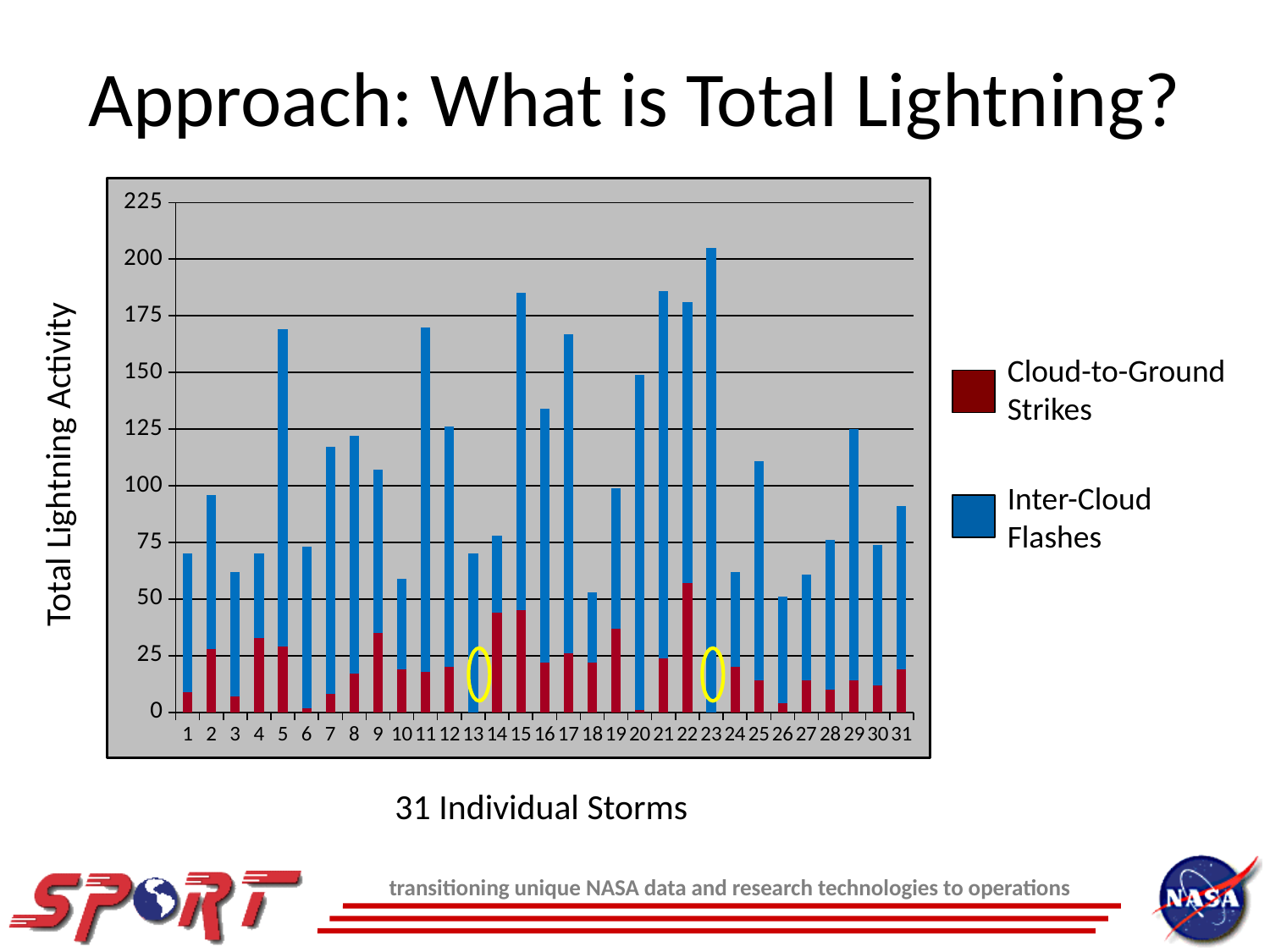
Which storm has the largest Cloud-to-Ground Strikes segment? 22 Which storm has a higher total lightning activity, storm 10 or storm 11? 11 What kind of chart is shown on the slide? Stacked bar chart How many series does the legend list? 2 Is the total lightning activity for storm 5 greater or less than 150? greater Is the Cloud-to-Ground Strikes value for storm 22 greater or less than 50? greater Is the total lightning activity for storm 1 greater or less than 100? less How many individual storms are plotted along the x axis? 31 Which series is shown in blue in the legend? Inter-Cloud Flashes What is the label on the y axis of the chart? Total Lightning Activity Which storm has the highest total lightning activity? 23